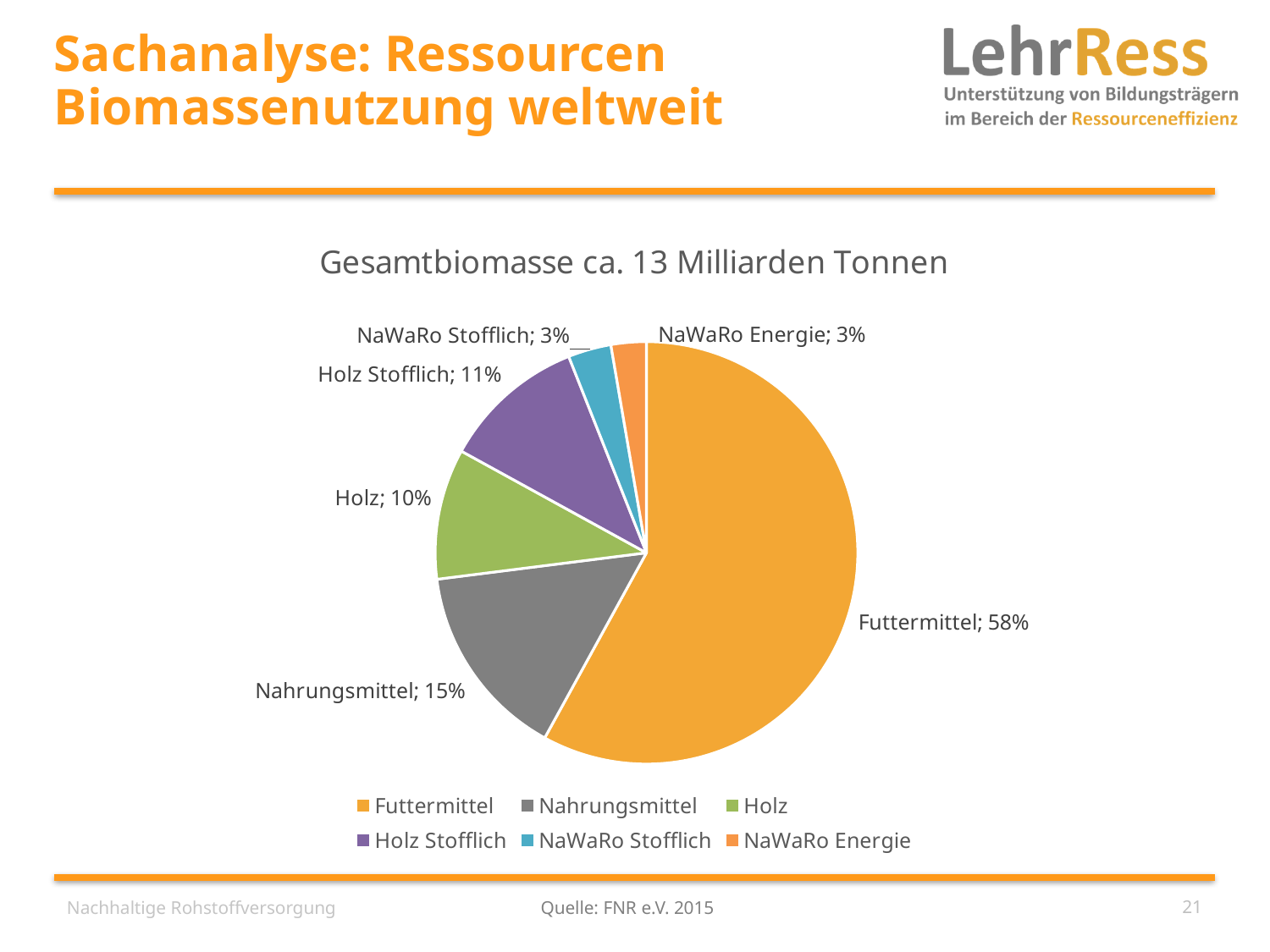
Which category has the largest slice of the pie? Futtermittel What share of the pie does Futtermittel have? 58% Which is larger, the share for Nahrungsmittel or the share for Holz? Nahrungsmittel What is the title of the chart? Gesamtbiomasse ca. 13 Milliarden Tonnen What share of the pie does Holz Stofflich have? 11% What share of the pie does Holz have? 10% What share of the pie does Nahrungsmittel have? 15% What is the difference in percentage points between Holz Stofflich and Holz? 1 What kind of chart is shown on the slide? Pie chart How many slices does the pie chart have? 6 How many entries does the legend list? 6 What is the difference in percentage points between Futtermittel and Nahrungsmittel? 43